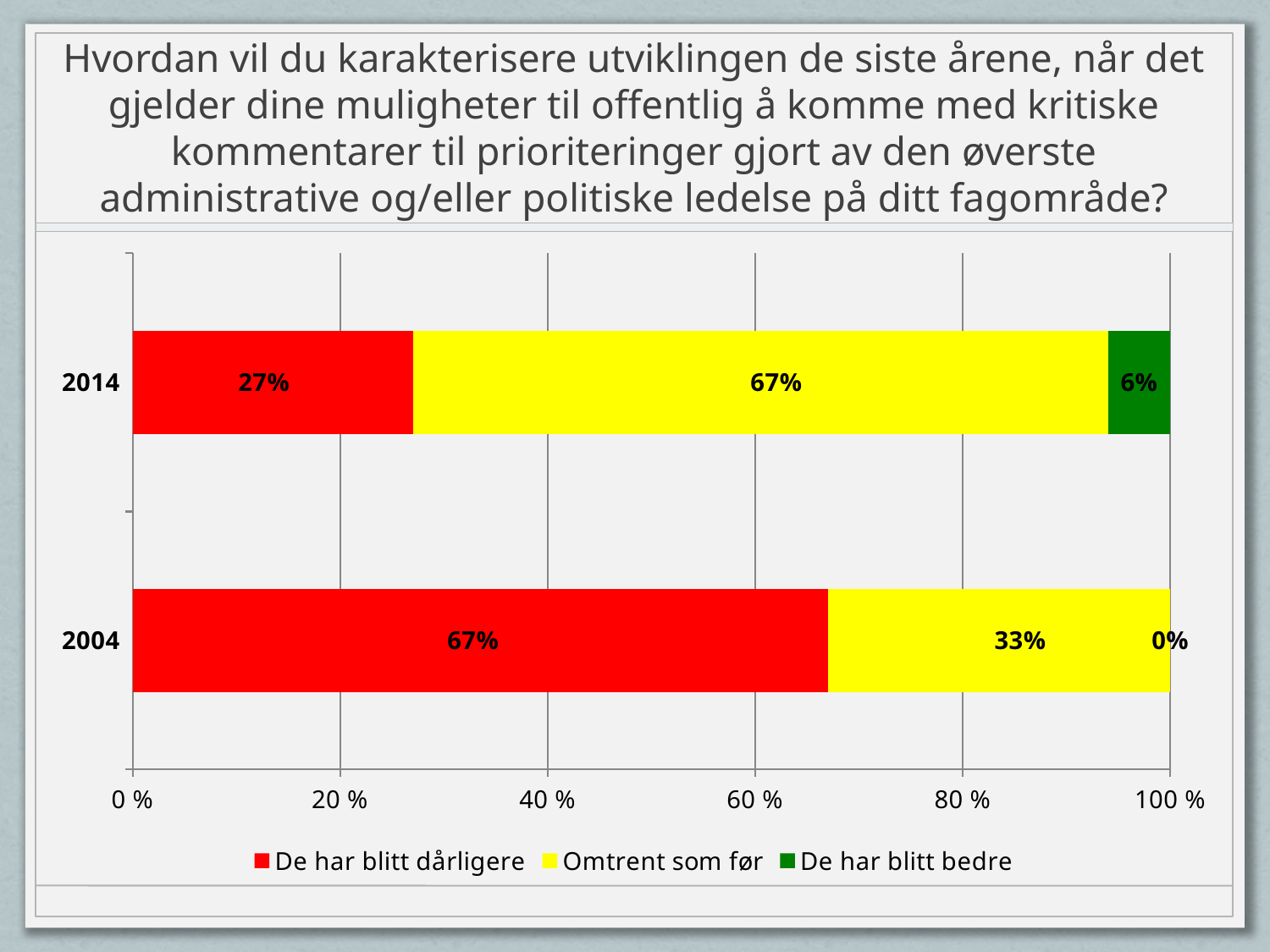
What is the value for "De har blitt bedre" in 2004? 0% How many series does the legend list? 3 Which colour represents "Omtrent som før" in the chart? Yellow How many years are shown on the chart? 2 What kind of chart is shown on the slide? Stacked bar chart What is the difference between the "Omtrent som før" values for 2014 and 2004? 34% What is the difference between the "De har blitt dårligere" values for 2004 and 2014? 40% What is the value for "Omtrent som før" in 2004? 33% What is the value for "De har blitt dårligere" in 2014? 27% What is the total of the stacked bar for 2014? 100% Which year has the higher value for "De har blitt dårligere"? 2004 What is the value for "De har blitt bedre" in 2014? 6%